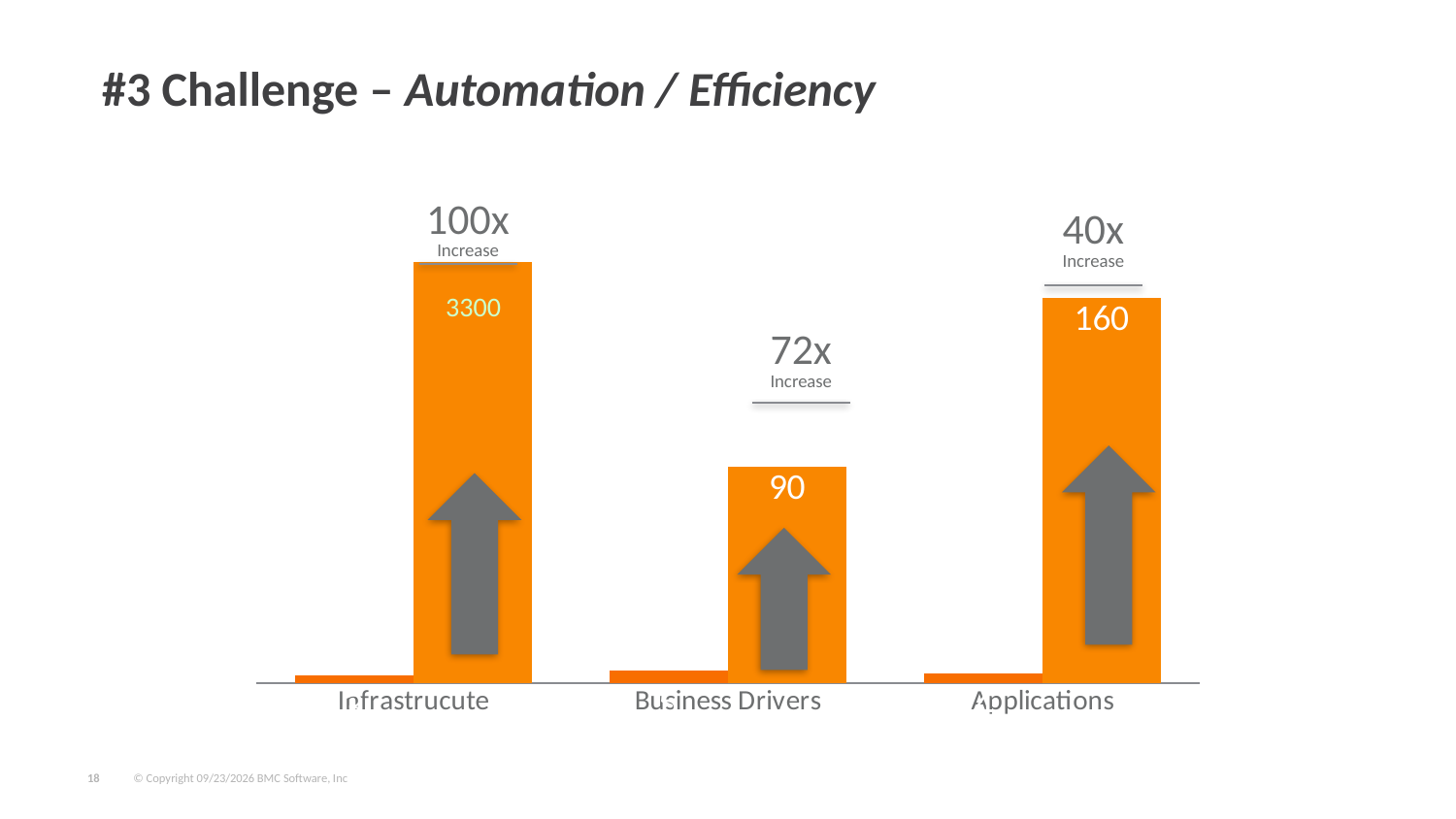
What kind of chart is shown on the slide? Bar chart Which category has the highest labelled bar value? Infrastrucute How many categories are shown on the x axis? 3 What increase factor is annotated above the Business Drivers bar? 72x What is the labelled value of the tall bar for Applications? 160 What is the labelled value of the tall bar for Business Drivers? 90 Which category has the lowest labelled bar value? Business Drivers What is the labelled value of the tall bar for Infrastrucute? 3300 What is the difference between the labelled values for Infrastrucute and Applications? 3140 What is the difference between the labelled values for Applications and Business Drivers? 70 Which is larger, the labelled value for Applications or for Business Drivers? Applications What increase factor is annotated above the Applications bar? 40x